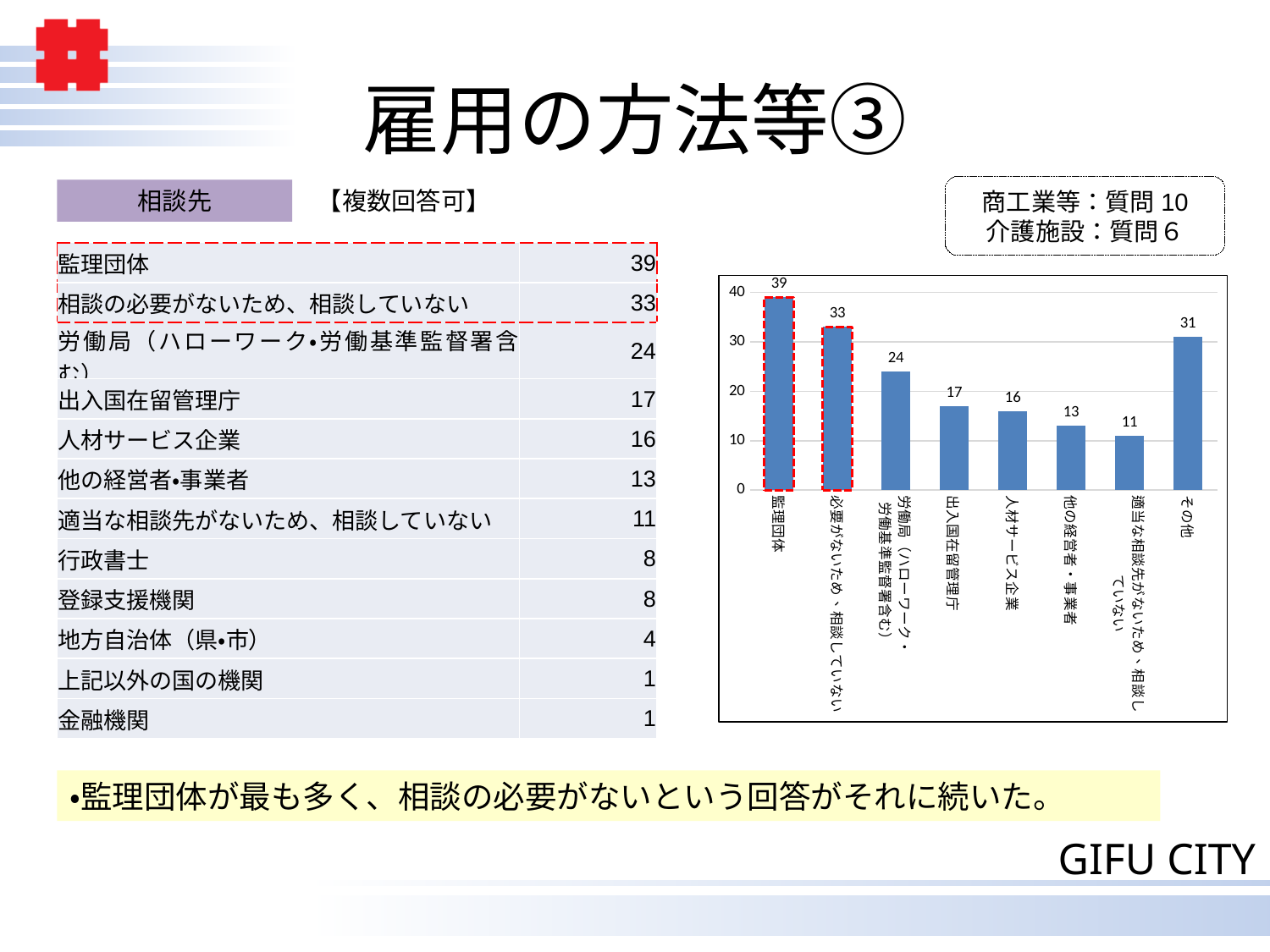
Which is larger in the chart: the value for その他 or the value for 労働局（ハローワーク・労働基準監督署含む）? その他 What is the difference between the values for 監理団体 and 相談の必要がないため、相談していない? 6 How many bars are plotted in the chart? 8 What is the value for 監理団体 in the chart? 39 What is the value for 出入国在留管理庁 in the chart? 17 What is the value for その他 in the chart? 31 Which category has the highest value in the chart? 監理団体 What is the highest value shown on the chart's vertical axis? 40 Is the value for 他の経営者・事業者 greater or less than 20? less What is the value for 人材サービス企業 in the chart? 16 Which category has the lowest value in the chart? 適当な相談先がないため、相談していない What kind of chart is shown on the slide? bar chart